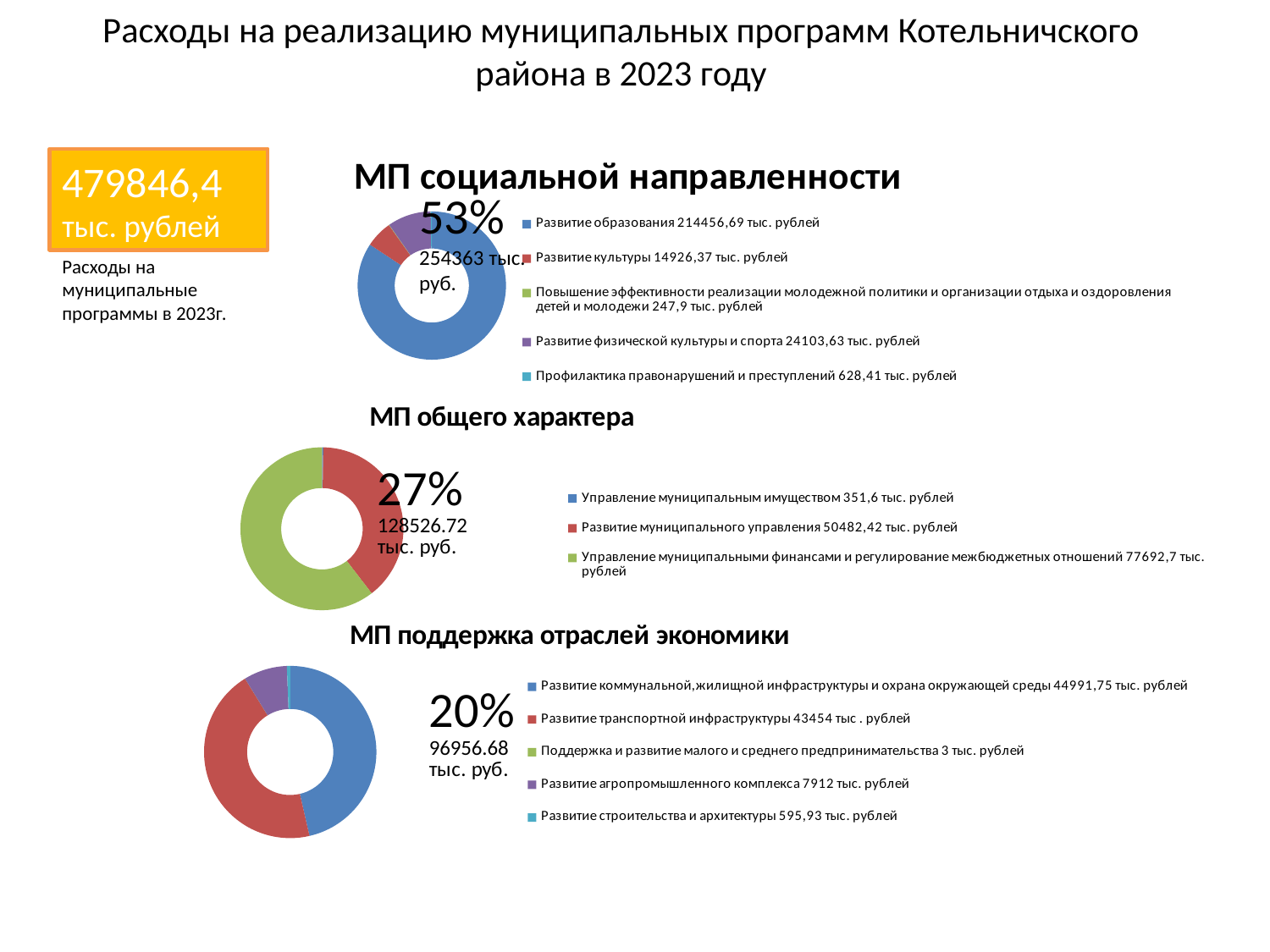
In the 'МП поддержка отраслей экономики' chart, which is larger: Развитие коммунальной, жилищной инфраструктуры и охрана окружающей среды or Развитие транспортной инфраструктуры? Развитие коммунальной, жилищной инфраструктуры и охрана окружающей среды In the 'МП социальной направленности' chart, what is the difference between Развитие физической культуры и спорта and Развитие культуры? 9177,26 тыс. рублей What share of total expenditure does the 'МП социальной направленности' chart show? 53% What total amount is shown next to the 'МП поддержка отраслей экономики' chart? 96956.68 тыс. руб. In the 'МП социальной направленности' chart, which category has the smallest value? Повышение эффективности реализации молодежной политики и организации отдыха и оздоровления детей и молодежи What kind of chart is the 'МП общего характера' chart? Doughnut (pie) chart In the 'МП поддержка отраслей экономики' chart, what is the value for Развитие агропромышленного комплекса? 7912 тыс. рублей In the 'МП общего характера' chart, what is the difference between Управление муниципальными финансами и регулирование межбюджетных отношений and Развитие муниципального управления? 27210,28 тыс. рублей In the 'МП общего характера' chart, which category has the largest value? Управление муниципальными финансами и регулирование межбюджетных отношений In the 'МП общего характера' chart, what is the value for Развитие муниципального управления? 50482,42 тыс. рублей In the 'МП социальной направленности' chart, what is the value for Развитие образования? 214456,69 тыс. рублей How many categories does the legend of the 'МП социальной направленности' chart list? 5